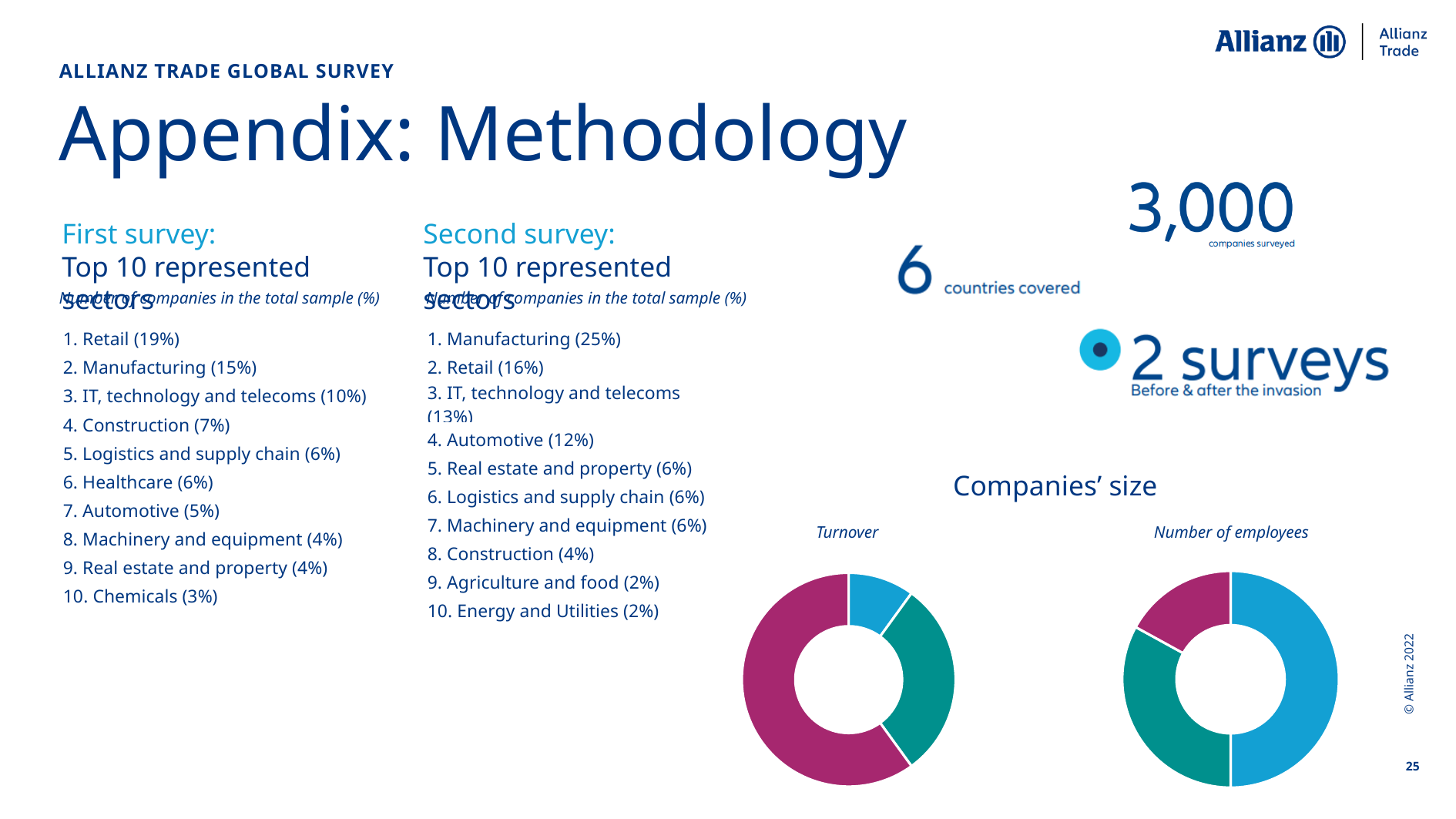
In the Number of employees chart, which colour slice is the largest? blue In the Number of employees chart, which colour slice is the smallest? magenta What kind of chart is the Turnover chart? doughnut chart In the Turnover chart, which colour slice is the largest? magenta In the Turnover chart, is the magenta slice greater or less than half of the pie? greater In the Turnover chart, which is larger, the magenta slice or the teal slice? magenta What is the heading shown above the two pie charts? Companies' size In the Turnover chart, which colour slice is the smallest? light blue In the Number of employees chart, which is larger, the teal slice or the magenta slice? teal How many slices does the Turnover chart have? 3 How many slices does the Number of employees chart have? 3 What kind of chart is the Number of employees chart? doughnut chart